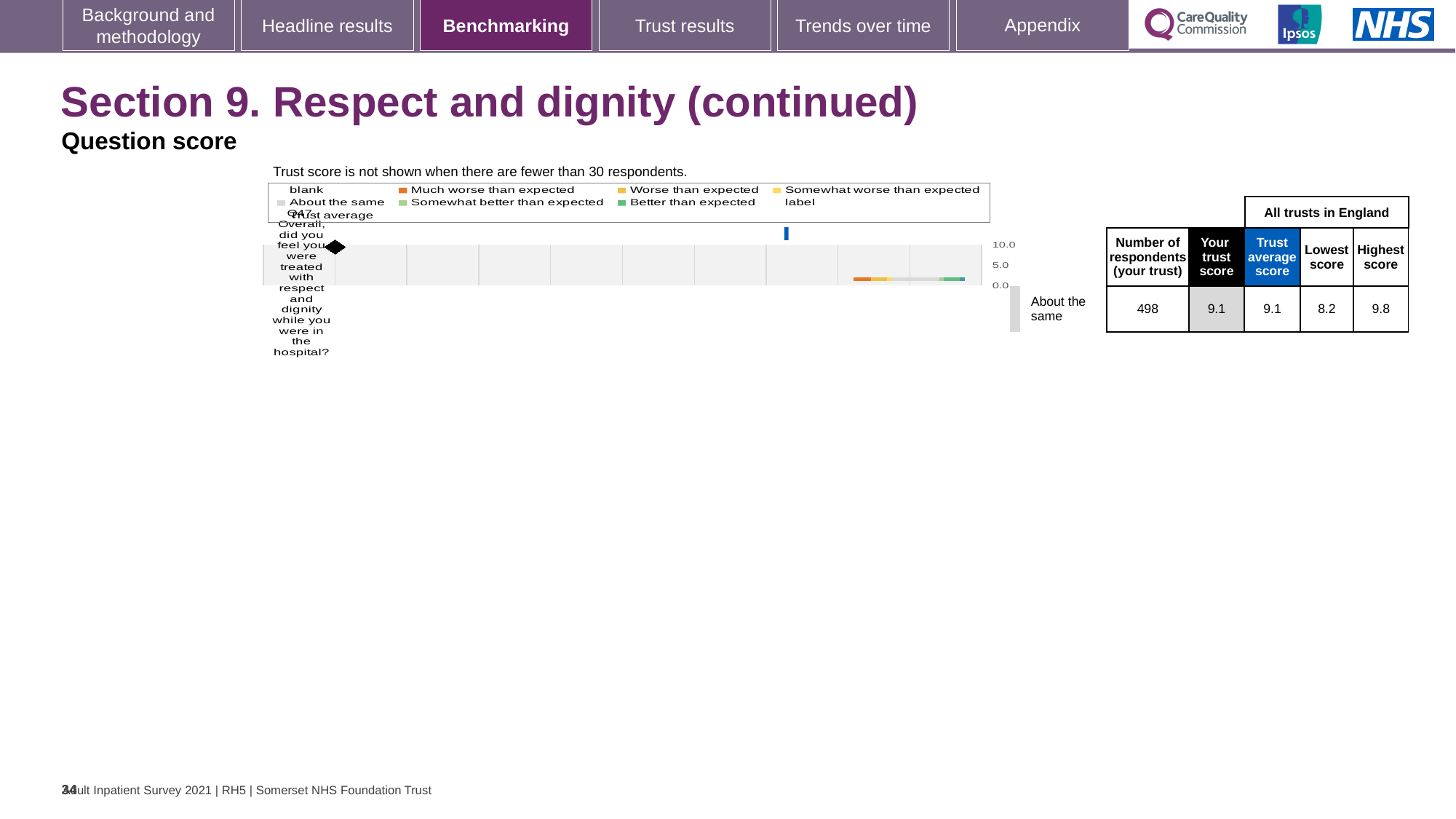
What is the lowest score among all trusts in England for Q47? 8.2 What is the 'Your trust score' value shown for Q47? 9.1 What is the number of respondents (your trust) shown for Q47? 498 Is your trust score for Q47 greater or less than 5.0? greater What is the difference between the highest score and the lowest score for Q47? 1.6 What is the maximum value shown on the chart's score axis? 10.0 Which is larger for Q47, the highest score or your trust score? Highest score Which legend entry is shown with an orange marker? Much worse than expected What is the highest score among all trusts in England for Q47? 9.8 What benchmark category is shown for Q47 next to the chart? About the same What kind of chart is used to show the Q47 benchmarking result? Bar chart What is the trust average score shown for Q47? 9.1